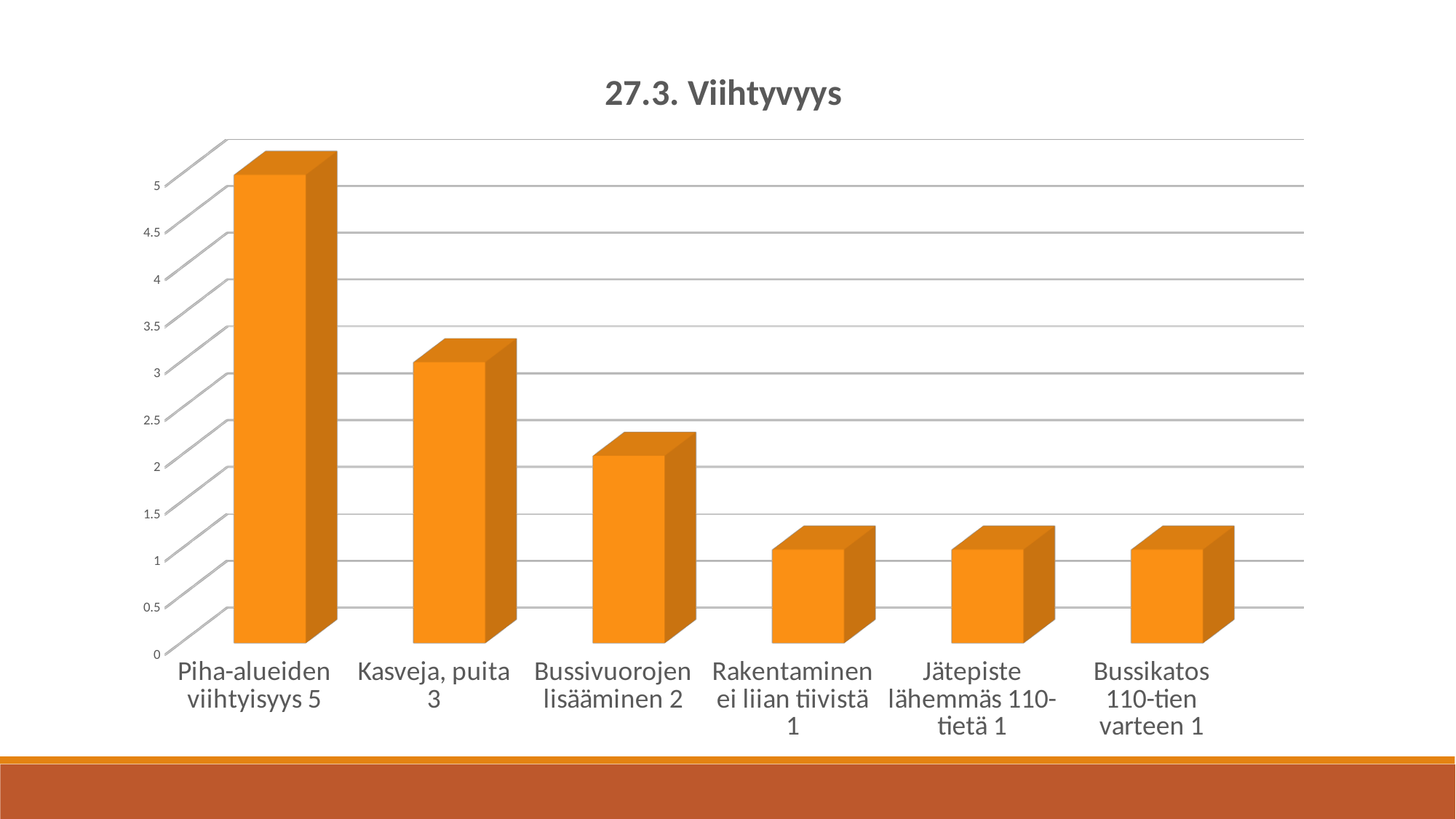
What kind of chart is shown on the slide? bar chart What is the difference between the values for Piha-alueiden viihtyisyys and Kasveja, puita? 2 What is the title of the chart? 27.3. Viihtyvyys Is the value for Piha-alueiden viihtyisyys greater or less than 4? greater What is the value for Piha-alueiden viihtyisyys? 5 What is the value for Jätepiste lähemmäs 110-tietä? 1 Do the values rise or fall from left to right along the x axis? fall What is the value for Bussivuorojen lisääminen? 2 Which category has the highest value? Piha-alueiden viihtyisyys Which is larger, the value for Kasveja, puita or the value for Bussivuorojen lisääminen? Kasveja, puita What is the value for Kasveja, puita? 3 How many categories are shown in the chart? 6